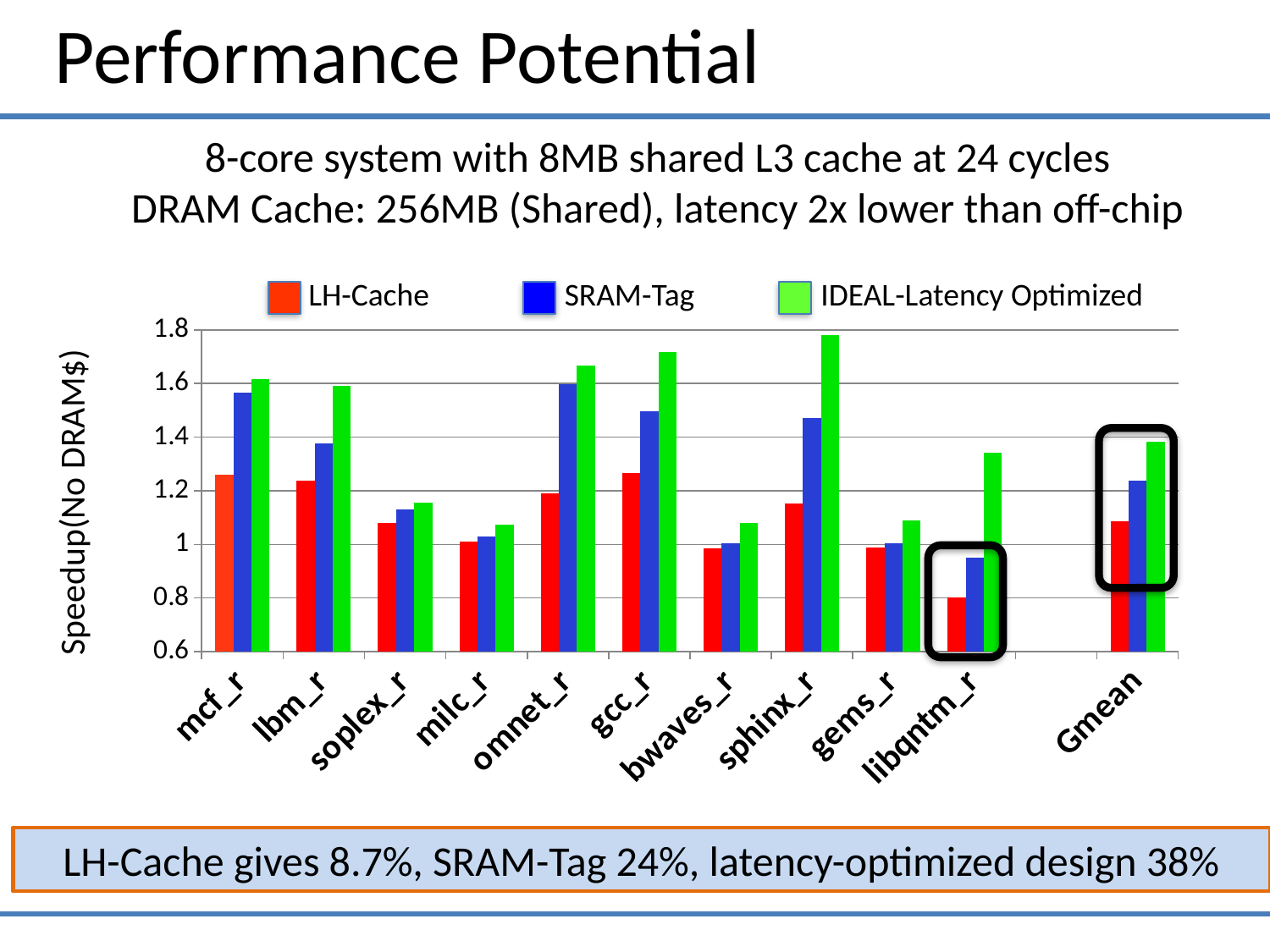
Is the SRAM-Tag value for soplex_r greater or less than 1.2? less Which category has the highest IDEAL-Latency Optimized bar? sphinx_r Is the LH-Cache value for Gmean greater or less than 1? greater What kind of chart is shown on the slide? bar chart How many series does the legend list? 3 For libqntm_r, which is larger, the SRAM-Tag bar or the IDEAL-Latency Optimized bar? IDEAL-Latency Optimized What is the label of the y axis? Speedup(No DRAM$) Is the LH-Cache value for mcf_r greater or less than 1.2? greater Which category has the lowest LH-Cache bar? libqntm_r How many categories are shown along the x axis? 11 Which is larger, the SRAM-Tag value for mcf_r or the SRAM-Tag value for lbm_r? mcf_r